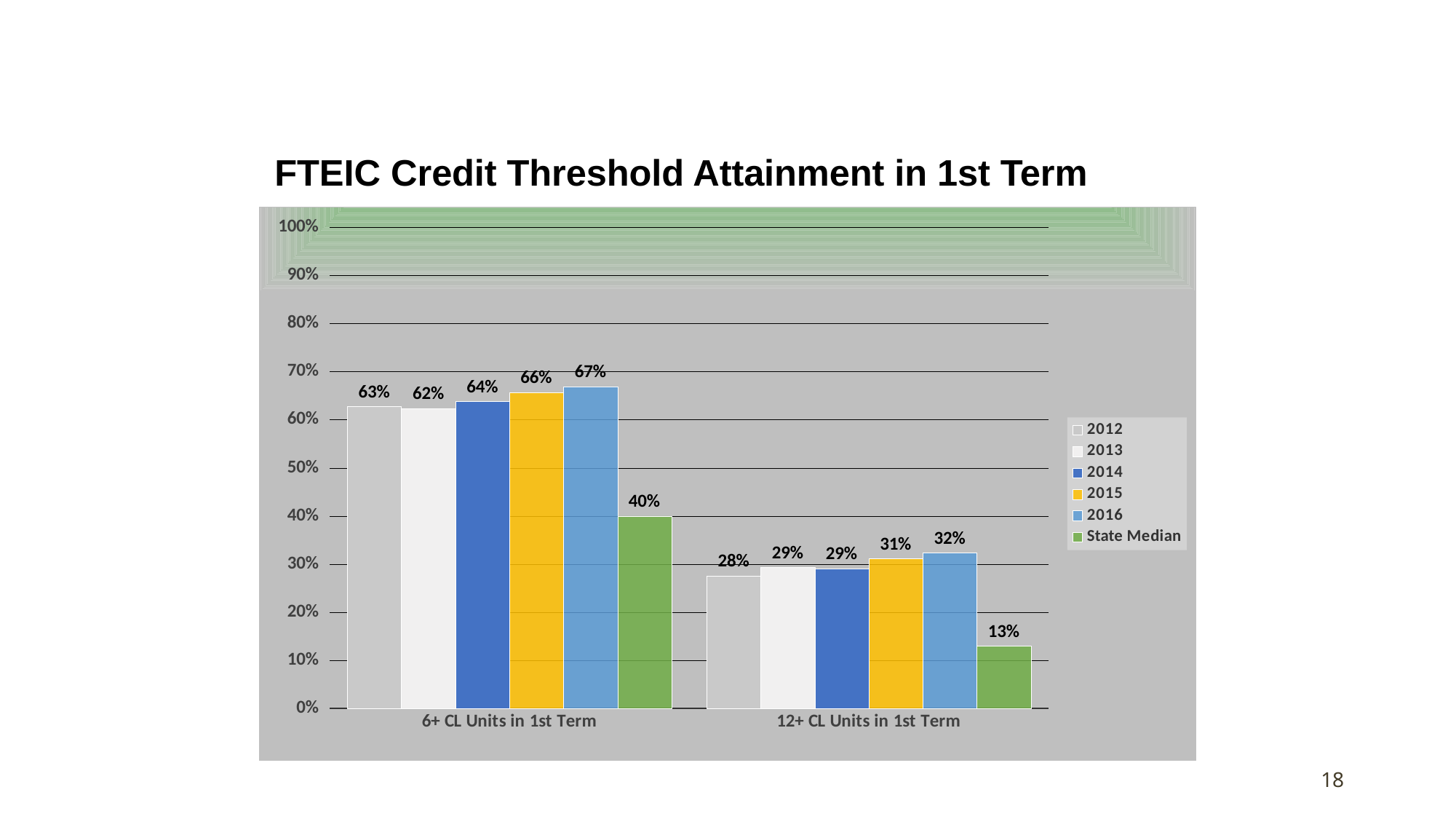
Which series has the lowest value in the 12+ CL Units in 1st Term category? State Median What is the value for 2016 in the 6+ CL Units in 1st Term category? 67% Is the 2014 value for 12+ CL Units in 1st Term greater or less than 30%? less What is the title of the chart? FTEIC Credit Threshold Attainment in 1st Term Which series has the highest value in the 6+ CL Units in 1st Term category? 2016 What is the difference between the 2016 value and the State Median value for 6+ CL Units in 1st Term? 27% How many series does the legend list? 6 Which is larger: the 2015 value for 6+ CL Units in 1st Term or the 2015 value for 12+ CL Units in 1st Term? 6+ CL Units in 1st Term What is the value for 2012 in the 12+ CL Units in 1st Term category? 28% How many categories are shown on the x axis? 2 What kind of chart is shown on the slide? bar chart What is the State Median value for 12+ CL Units in 1st Term? 13%